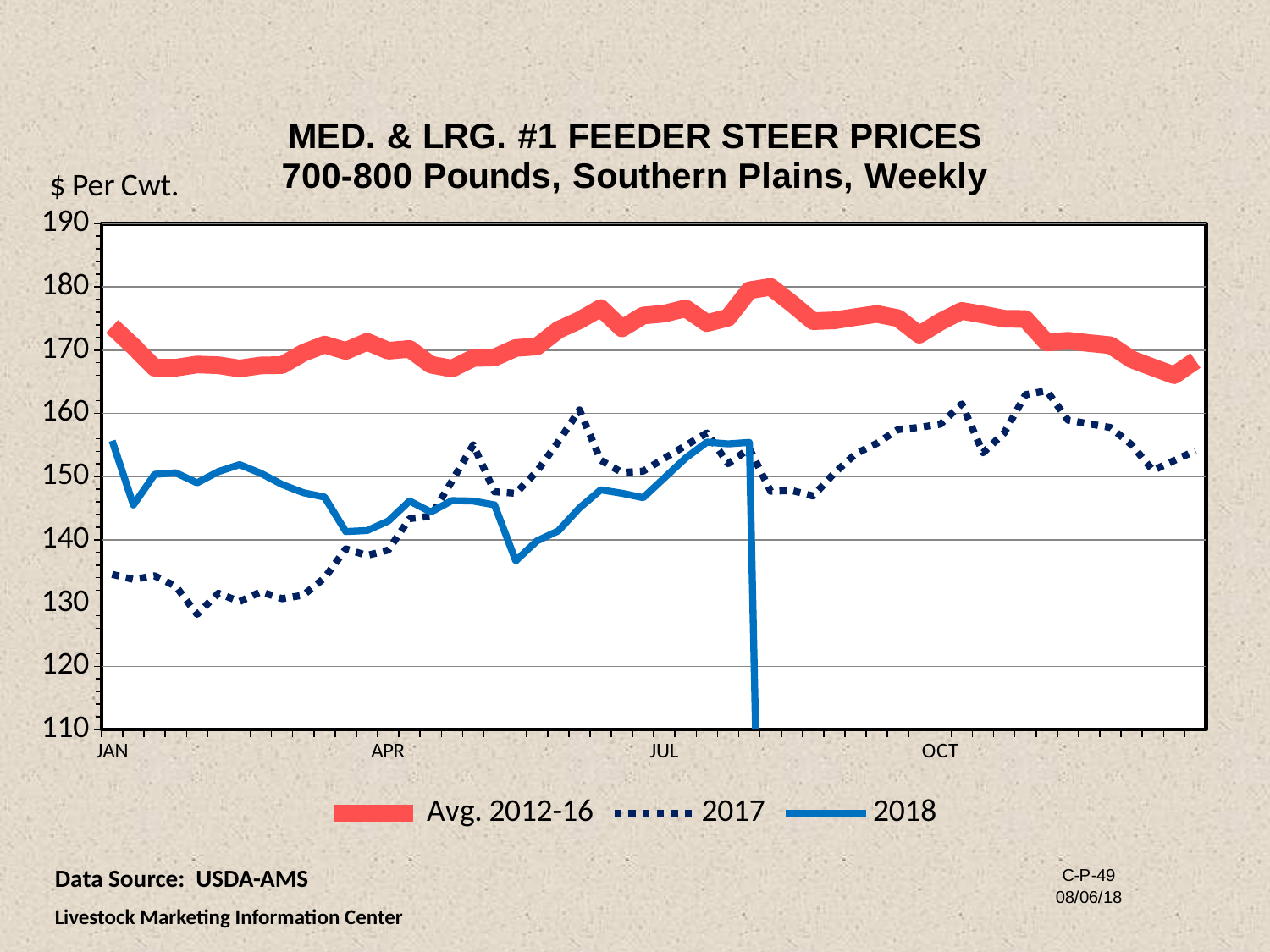
Does the Avg. 2012-16 line rise or fall from OCT to the end of the year? fall Is the Avg. 2012-16 value at JAN greater or less than 170? greater What kind of chart is shown on the slide? line chart Is the 2017 value at OCT greater or less than 150? greater Which series is plotted highest across the whole chart? Avg. 2012-16 At JAN, which is larger: the 2017 value or the 2018 value? 2018 What unit is shown on the vertical axis label? $ Per Cwt. What are the three series listed in the legend? Avg. 2012-16, 2017, 2018 How many series does the legend list? 3 Is the 2017 value at JAN greater or less than 140? less Does the 2017 line generally rise or fall from JAN to OCT? rise